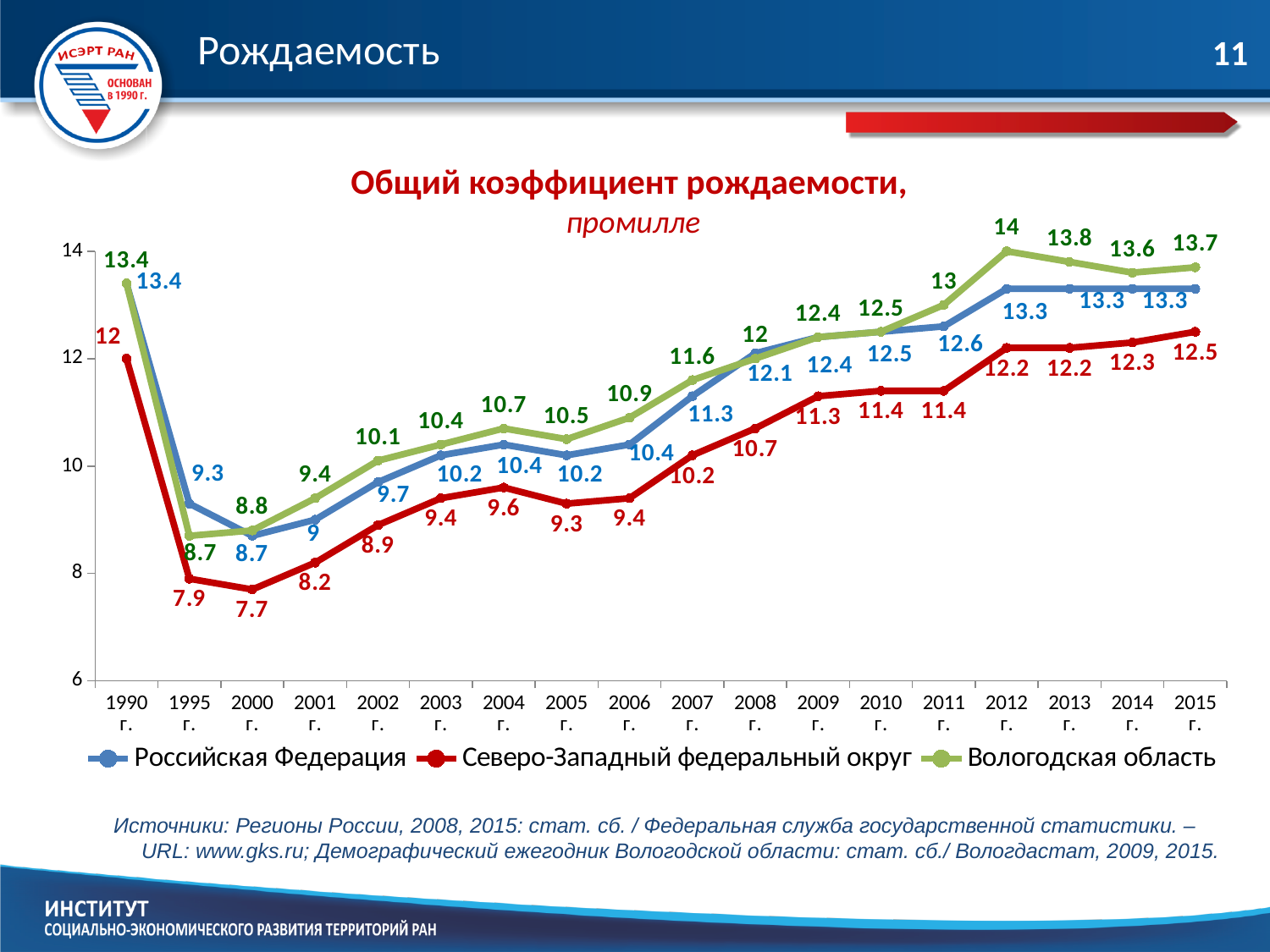
What is the value for Северо-Западный федеральный округ in 2000? 7.7 In which year is the value for Вологодская область highest? 2012 What is the difference between the Вологодская область value and the Северо-Западный федеральный округ value in 2012? 1.8 What is the value for Российская Федерация in 2015? 13.3 What kind of chart is shown on the slide? Line chart How many series does the legend list? 3 How many years are shown on the x axis? 18 Do the values for Северо-Западный федеральный округ rise or fall from 2000 to 2015? Rise What unit is named in the chart subtitle? промилле Which series has the larger value in 2011: Российская Федерация or Вологодская область? Вологодская область In which year is the value for Северо-Западный федеральный округ lowest? 2000 What is the value for Вологодская область in 2012? 14